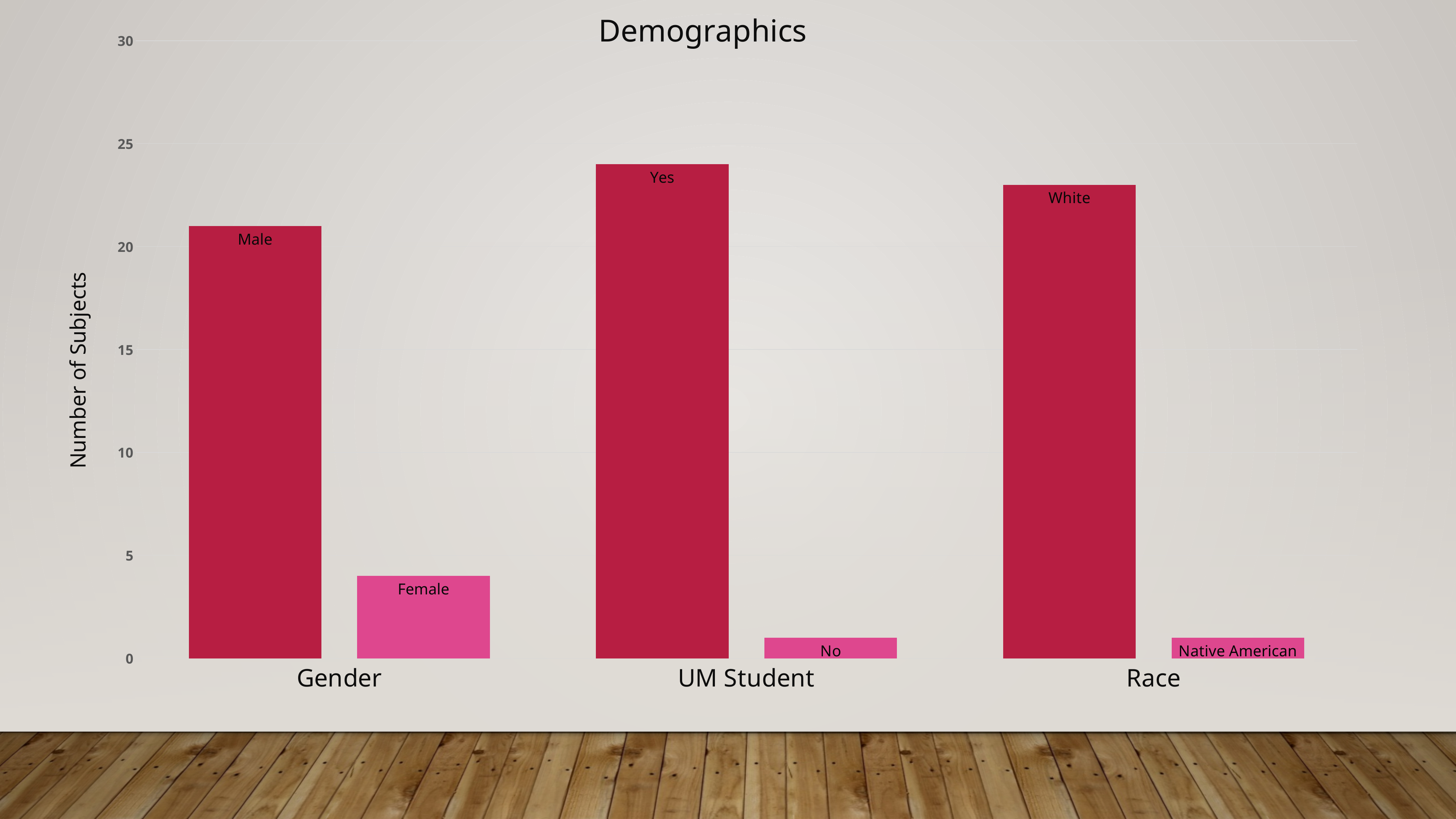
Which bar is taller, Male or White? White Is the value for Native American greater or less than 5? less Is the value for White greater or less than 20? greater Is the value for Yes (UM Student) greater or less than 25? less What is the label on the vertical axis of the chart? Number of Subjects Which bar is taller, Male or Female? Male How many bars are plotted in the chart? 6 What type of chart is shown on the slide? bar chart What is the title of the chart? Demographics How many category groups are shown along the x axis? 3